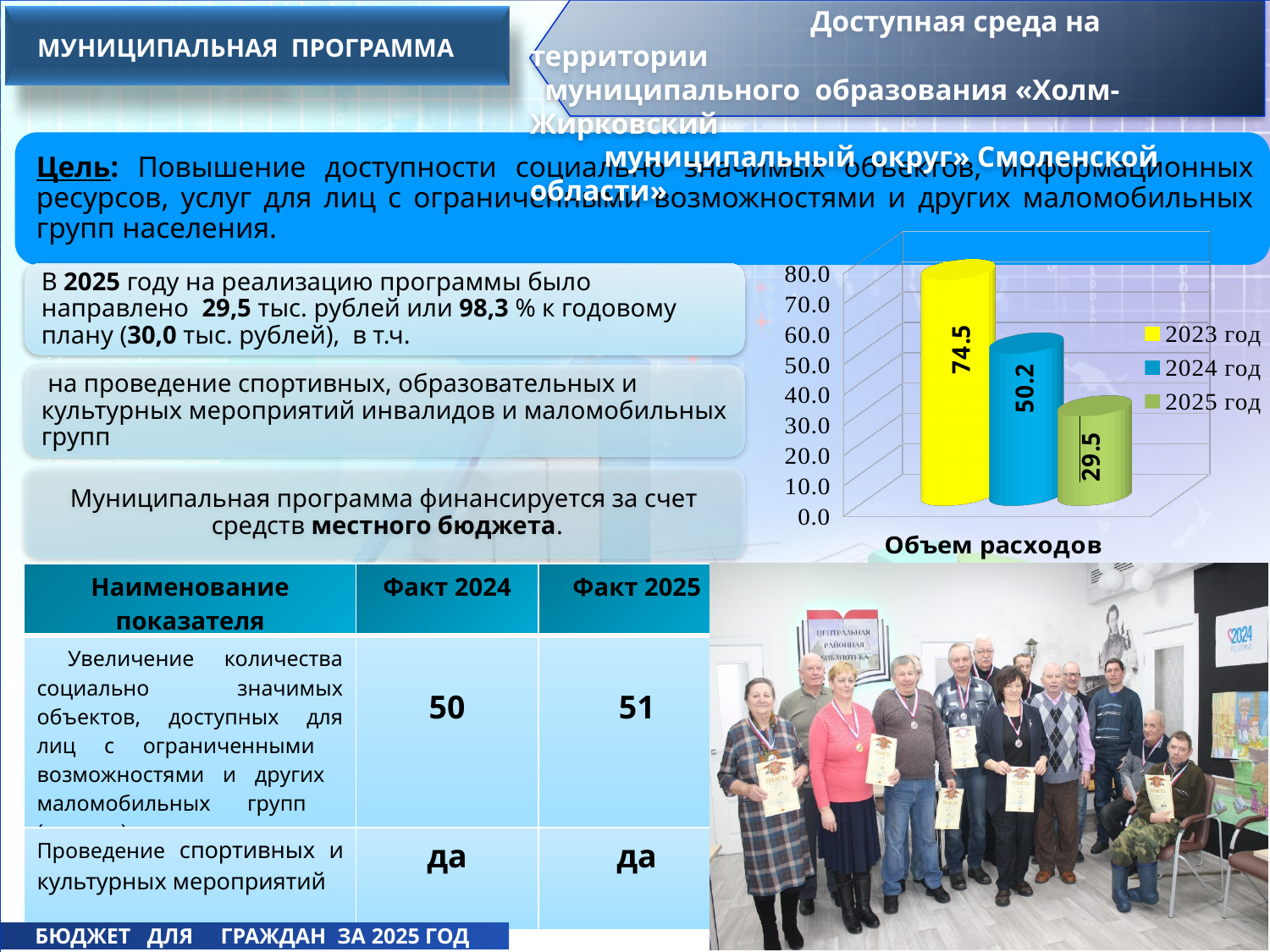
What is the difference between the values for 2024 год and 2025 год in the Объем расходов chart? 20.7 Do the values in the Объем расходов chart rise or fall from 2023 год to 2025 год? fall What kind of chart is the Объем расходов chart? bar chart How many series does the legend of the Объем расходов chart list? 3 What is the value for 2023 год in the Объем расходов chart? 74.5 What is the difference between the values for 2023 год and 2025 год in the Объем расходов chart? 45.0 What is the value for 2024 год in the Объем расходов chart? 50.2 Is the value for 2023 год in the Объем расходов chart greater or less than 70.0? greater Which year has the highest value in the Объем расходов chart? 2023 год Which is larger in the Объем расходов chart, the value for 2024 год or 2025 год? 2024 год What is the value for 2025 год in the Объем расходов chart? 29.5 Which year has the lowest value in the Объем расходов chart? 2025 год